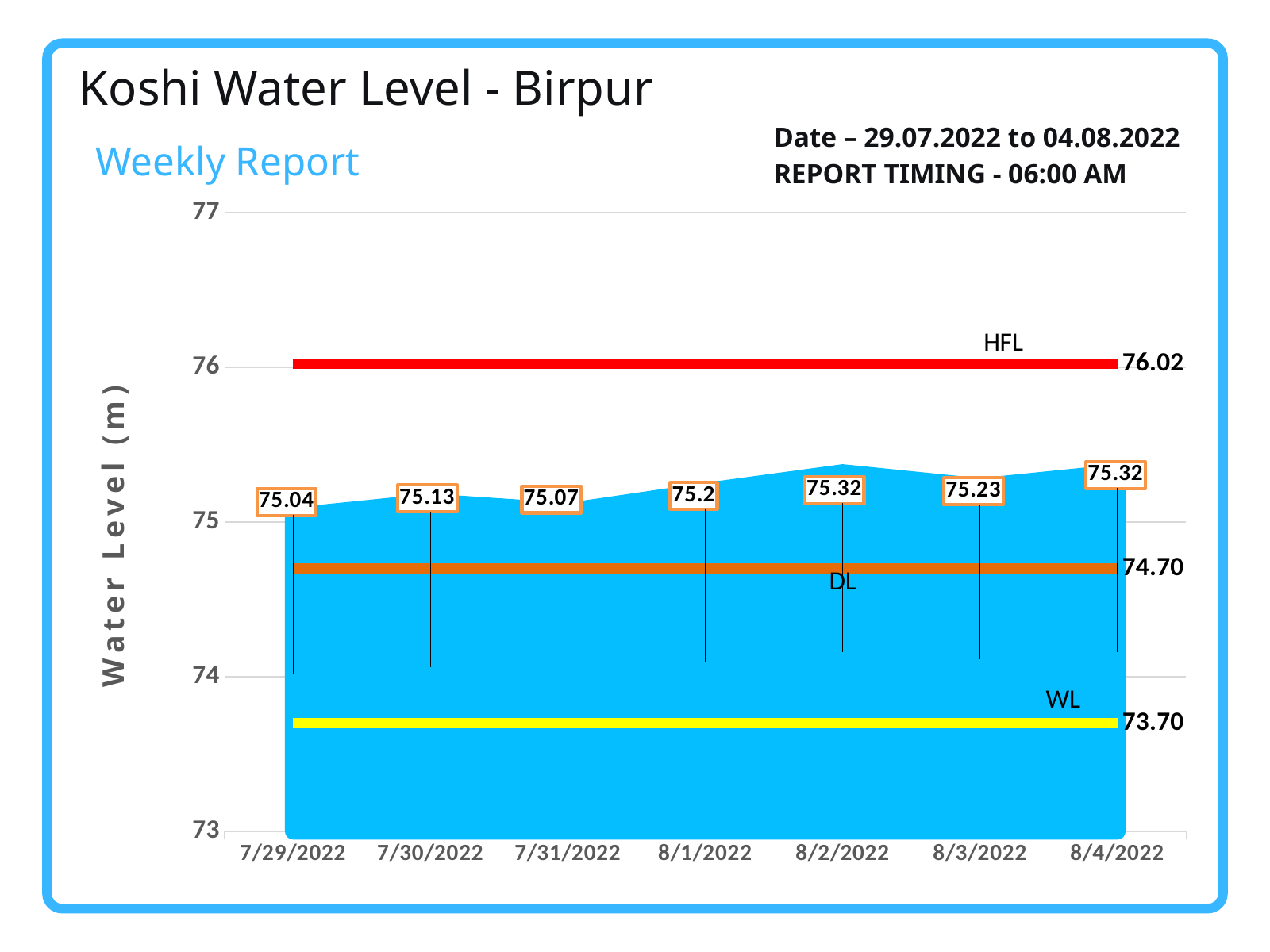
What value is labelled for the DL line? 74.70 How many dates are plotted on the x axis? 7 What is the y-axis label of the chart? Water Level (m) What is the water level on 8/1/2022? 75.2 What is the difference between the water level on 8/2/2022 and on 7/29/2022? 0.28 What is the title of the chart? Koshi Water Level - Birpur Which is higher, the water level on 7/30/2022 or on 7/31/2022? 7/30/2022 What is the water level on 7/29/2022? 75.04 What value is labelled for the HFL line? 76.02 What is the water level on 8/3/2022? 75.23 What value is labelled for the WL line? 73.70 On which date is the water level lowest? 7/29/2022